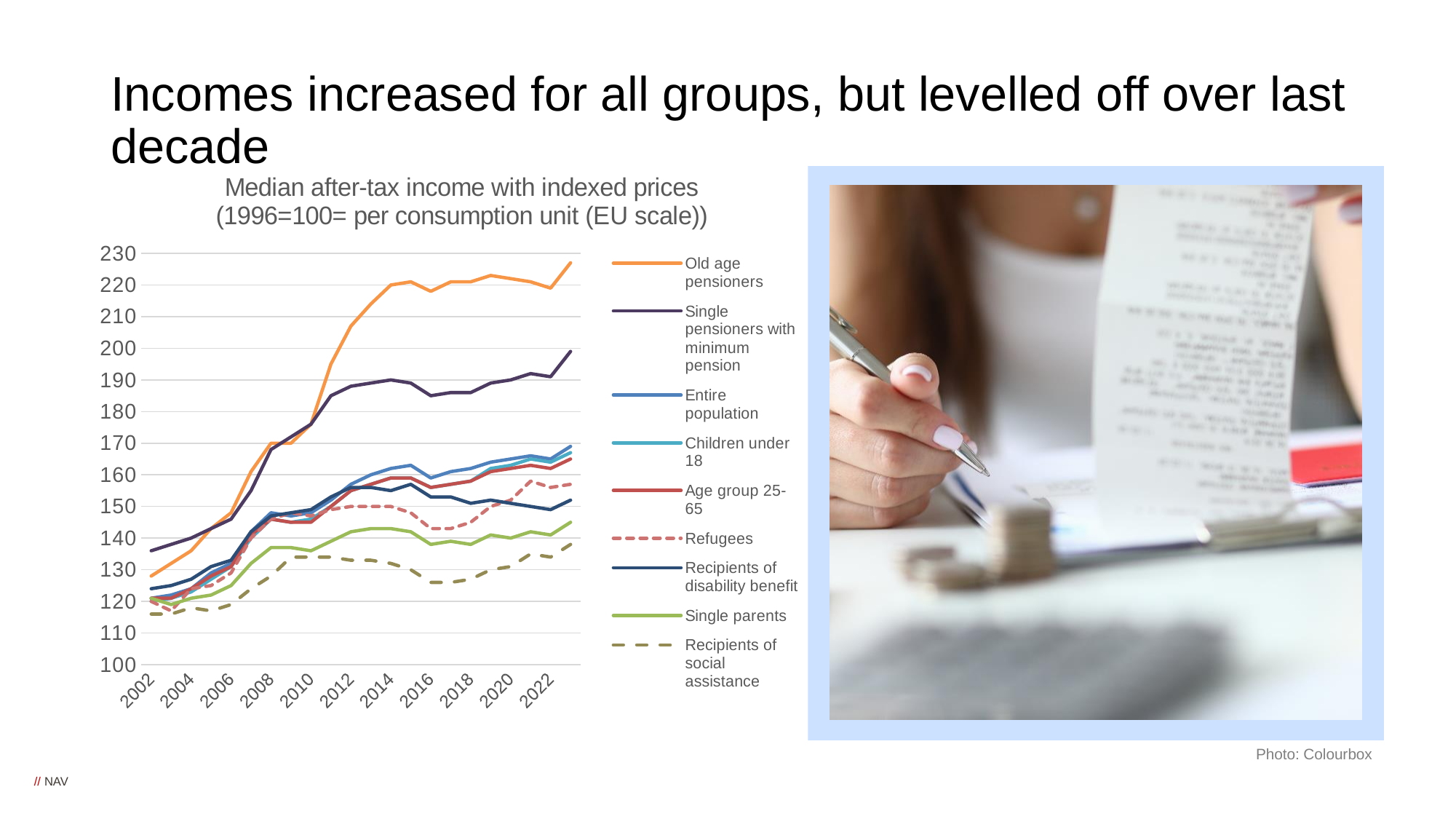
What is the title of the chart? Median after-tax income with indexed prices (1996=100= per consumption unit (EU scale)) Is the value for Old age pensioners in 2022 greater or less than 210? greater What kind of chart is shown on the slide? Line chart Is the value for Single pensioners with minimum pension in 2022 greater or less than 180? greater How many series does the legend list? 9 Do the values for Old age pensioners rise or fall from 2002 to 2014? Rise Which group has the lowest index value in 2022? Recipients of social assistance Is the value for Recipients of social assistance in 2016 greater or less than 130? less In 2022, which is higher: Refugees or Recipients of disability benefit? Refugees Which group has the highest index value in 2022? Old age pensioners In 2022, which is higher: Single parents or Recipients of social assistance? Single parents